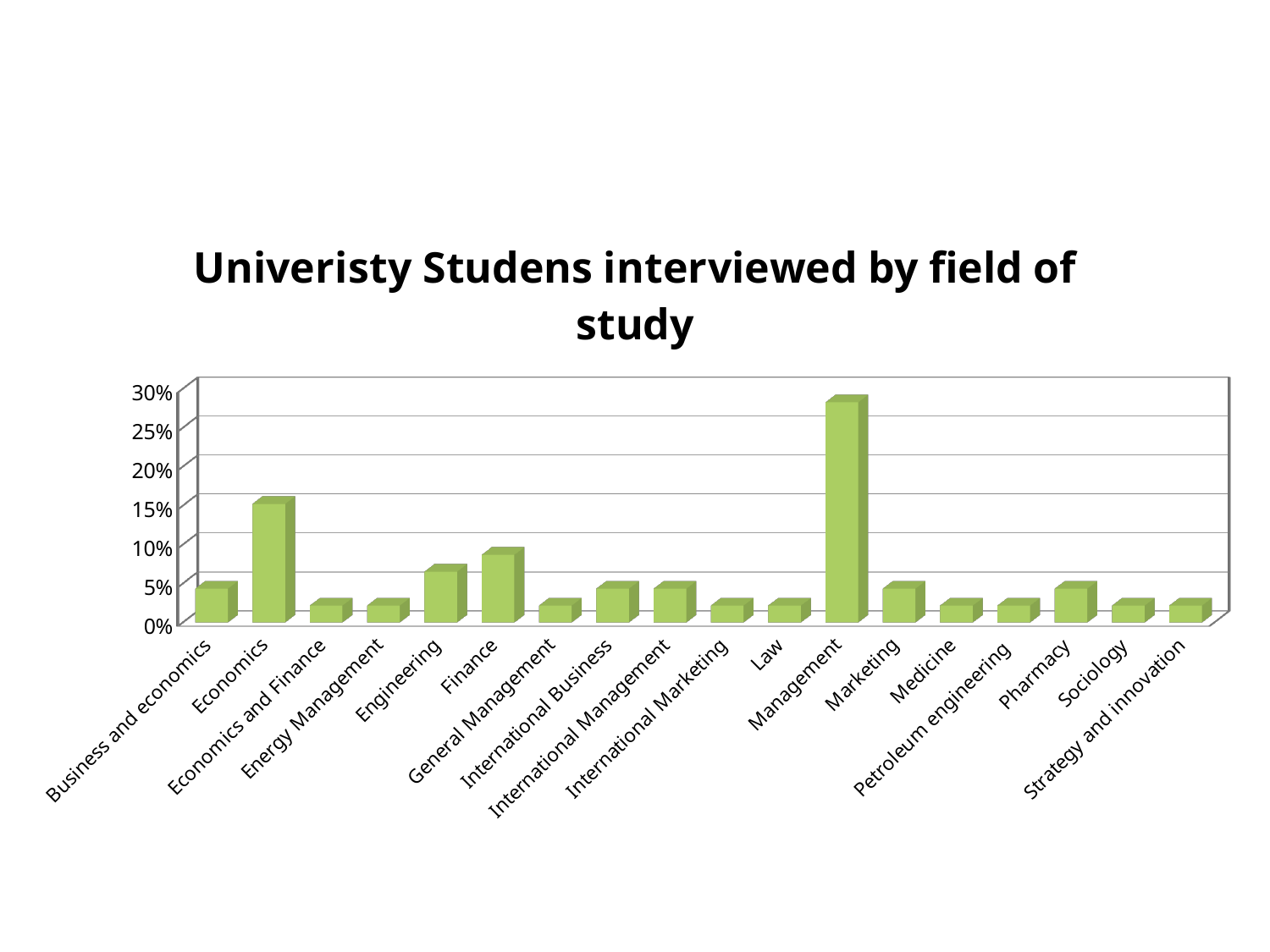
Which field of study has the highest share of students interviewed? Management What kind of chart is shown on the slide? Bar chart Which is larger, the value for Finance or the value for Engineering? Finance Is the value for Law greater or less than 5%? less Is the value for Finance greater or less than 10%? less How many fields of study are shown on the x axis of the chart? 18 Which is larger, the value for Economics or the value for Finance? Economics Is the value for Engineering greater or less than 5%? greater What is the title of the chart? Univeristy Studens interviewed by field of study Which is larger, the value for Management or the value for Economics? Management